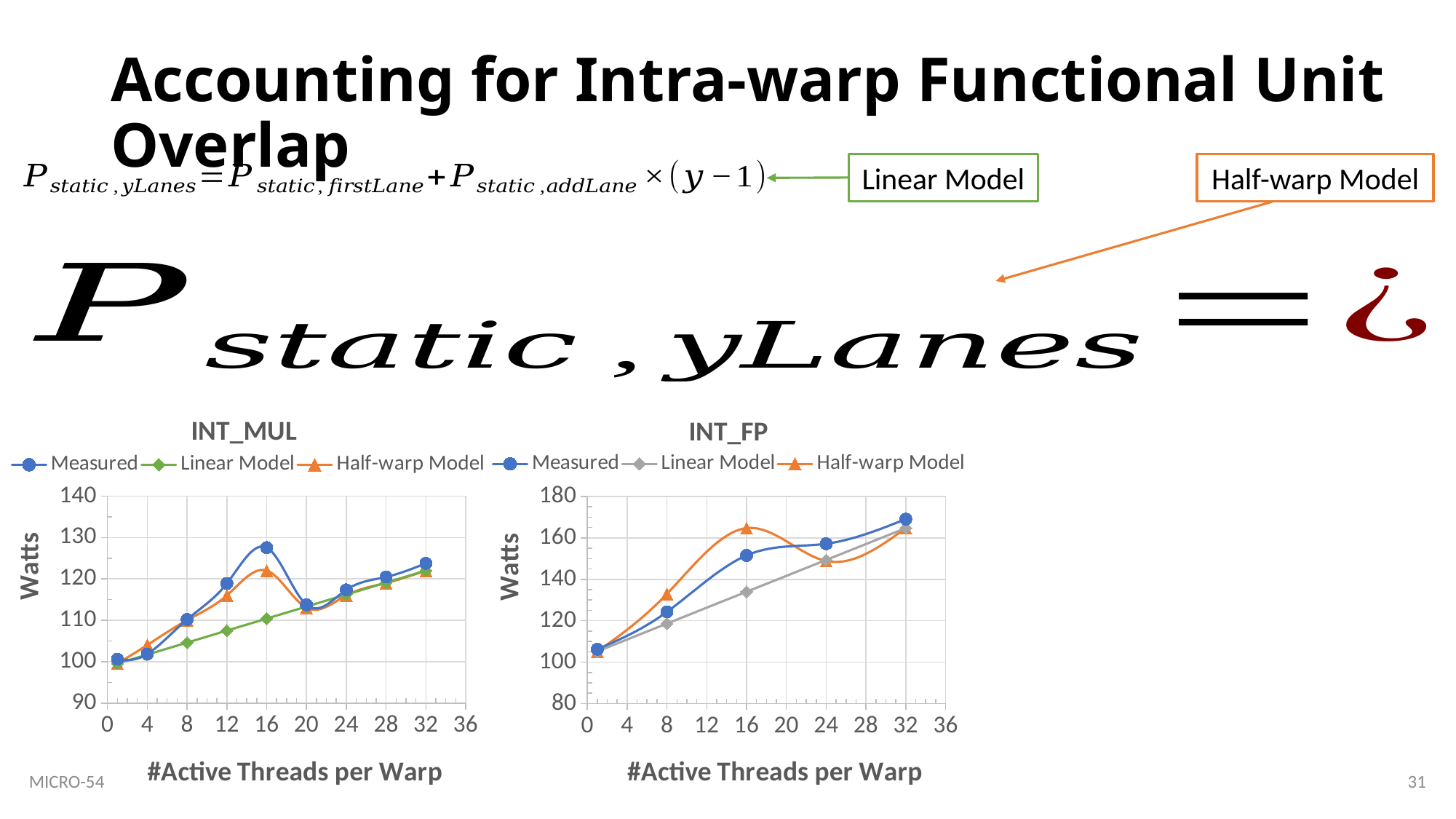
What kind of chart is the INT_MUL chart? line chart In the INT_FP chart, which is larger at 8 active threads per warp, the Half-warp Model or the Linear Model? Half-warp Model In the INT_MUL chart, which series has the highest value at 16 active threads per warp? Measured In the INT_FP chart, does the Linear Model series rise or fall as the number of active threads per warp increases? rise In the INT_FP chart, is the Half-warp Model value at 16 active threads per warp greater or less than 160? greater In the INT_MUL chart, is the Linear Model value at 16 active threads per warp greater or less than 120? less How many data points does the Measured series have in the INT_FP chart? 5 What is the y-axis label of the INT_MUL chart? Watts In the INT_MUL chart, is the Measured value at 16 active threads per warp greater or less than 120? greater How many series does the legend of the INT_FP chart list? 3 What is the x-axis label of the INT_FP chart? #Active Threads per Warp